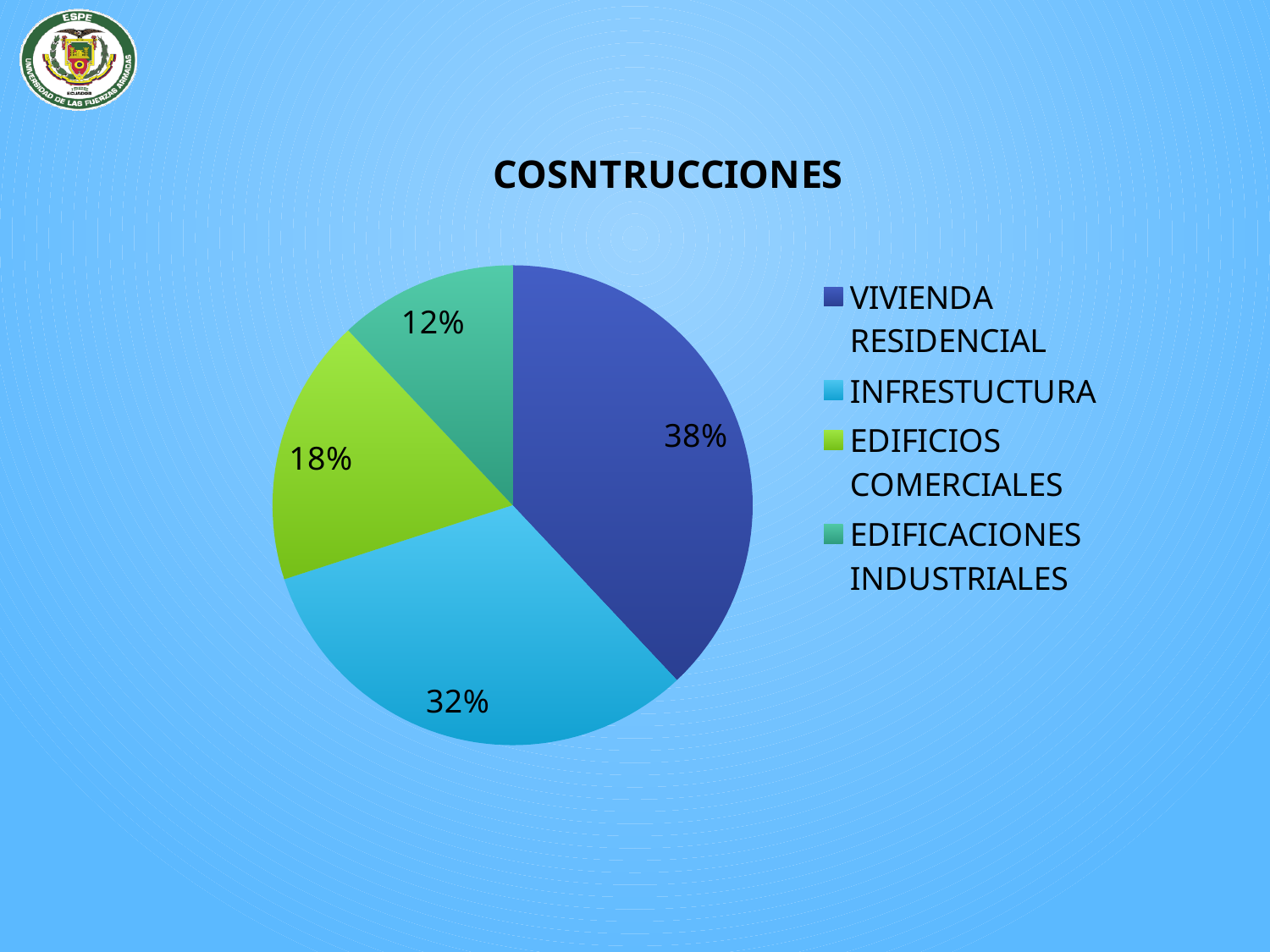
Which is larger, the share for INFRESTUCTURA or the share for EDIFICIOS COMERCIALES? INFRESTUCTURA How many categories are shown in the pie chart? 4 What share of the pie does EDIFICIOS COMERCIALES represent? 18% What is the difference in percentage points between VIVIENDA RESIDENCIAL and INFRESTUCTURA? 6% What is the difference in percentage points between EDIFICIOS COMERCIALES and EDIFICACIONES INDUSTRIALES? 6% What share of the pie does VIVIENDA RESIDENCIAL represent? 38% Which category has the largest slice of the pie? VIVIENDA RESIDENCIAL Which category has the smallest slice of the pie? EDIFICACIONES INDUSTRIALES What share of the pie does INFRESTUCTURA represent? 32% What is the title of the chart? COSNTRUCCIONES What kind of chart is shown on the slide? Pie chart